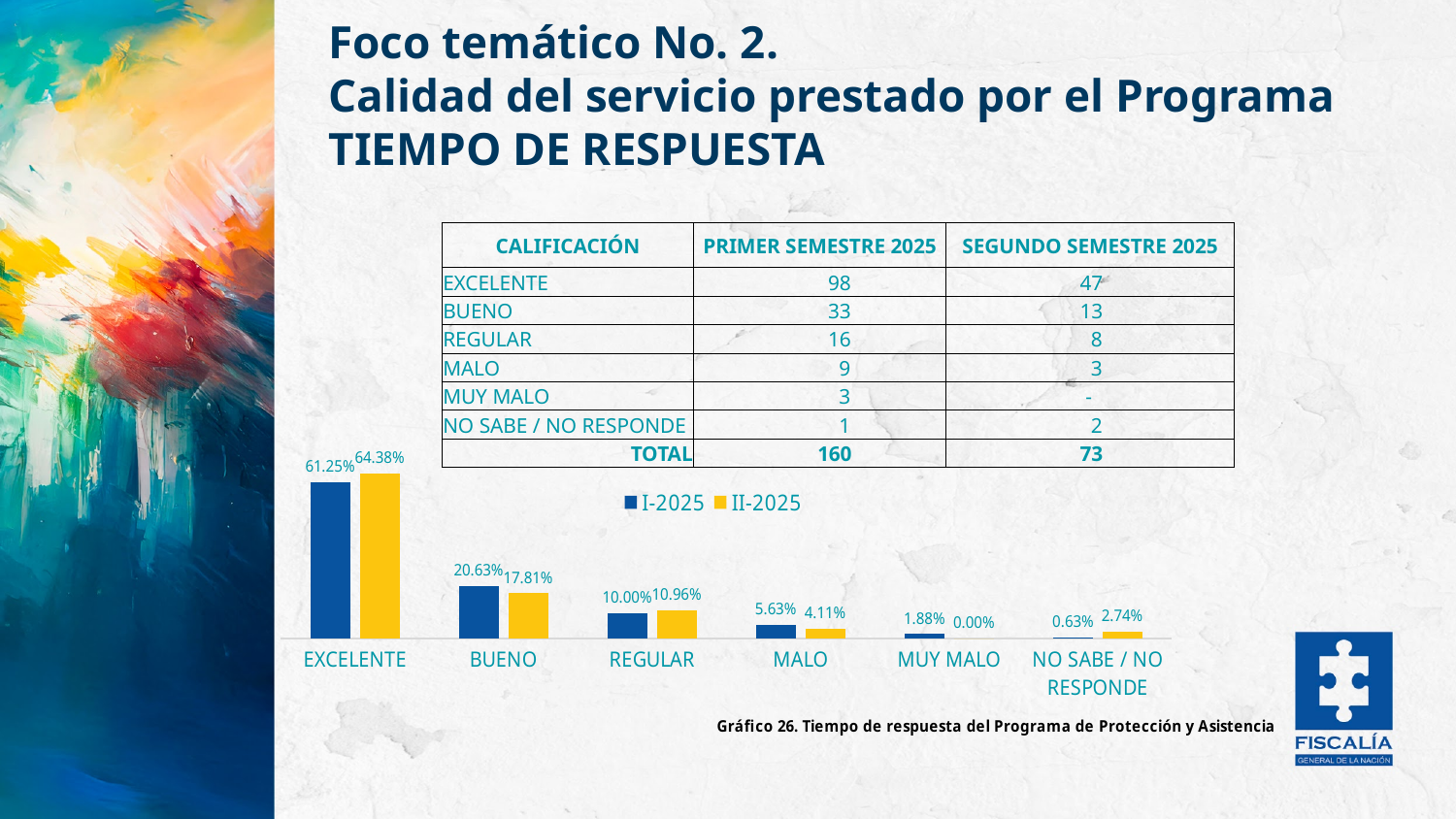
What is the value for MUY MALO in the II-2025 series? 0.00% What is the difference between the I-2025 and II-2025 values for BUENO? 2.82% How many categories are shown on the x axis of the chart? 6 What kind of chart is shown on the slide? bar chart How many series does the chart legend list? 2 Which category has the lowest value in the I-2025 series? NO SABE / NO RESPONDE For MALO, which series has the larger value, I-2025 or II-2025? I-2025 What is the value for BUENO in the II-2025 series? 17.81% What are the two legend entries of the chart? I-2025 and II-2025 Which category has the highest value in the I-2025 series? EXCELENTE What is the value for EXCELENTE in the I-2025 series? 61.25% What is the value for EXCELENTE in the II-2025 series? 64.38%